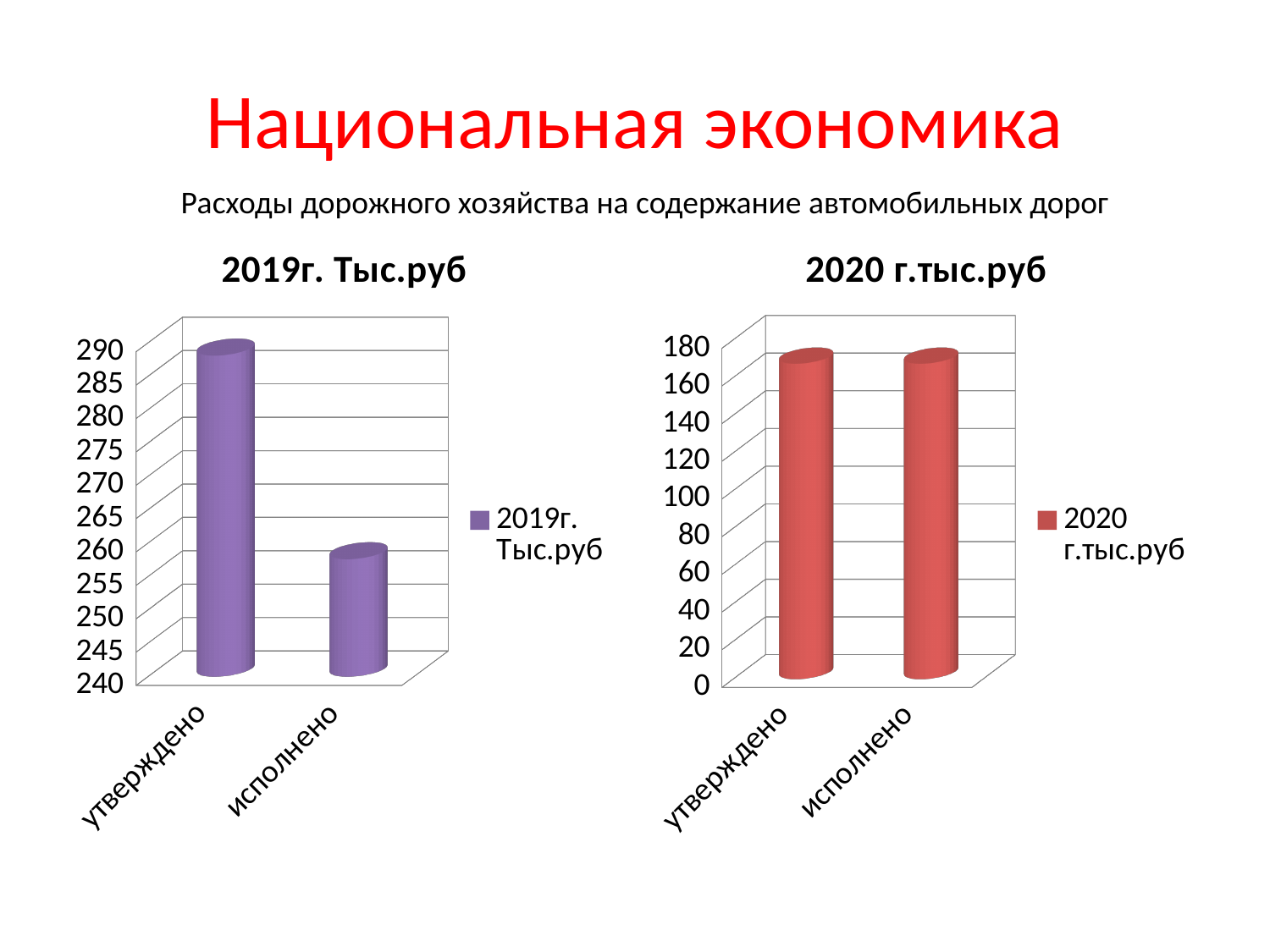
In the left chart titled "2019г. Тыс.руб", is the value for исполнено greater or less than 250? greater What is the legend entry of the left chart titled "2019г. Тыс.руб"? 2019г. Тыс.руб In the left chart titled "2019г. Тыс.руб", which category has the lowest value? исполнено How many categories are shown on the x axis of the left chart titled "2019г. Тыс.руб"? 2 In the left chart titled "2019г. Тыс.руб", which category has the highest value? утверждено In the left chart titled "2019г. Тыс.руб", which is larger: утверждено or исполнено? утверждено In the left chart titled "2019г. Тыс.руб", is the value for утверждено greater or less than 280? greater How many series does the legend of the right chart titled "2020 г.тыс.руб" list? 1 What kind of chart is the left chart titled "2019г. Тыс.руб"? bar chart In the right chart titled "2020 г.тыс.руб", is the value for исполнено greater or less than 180? less